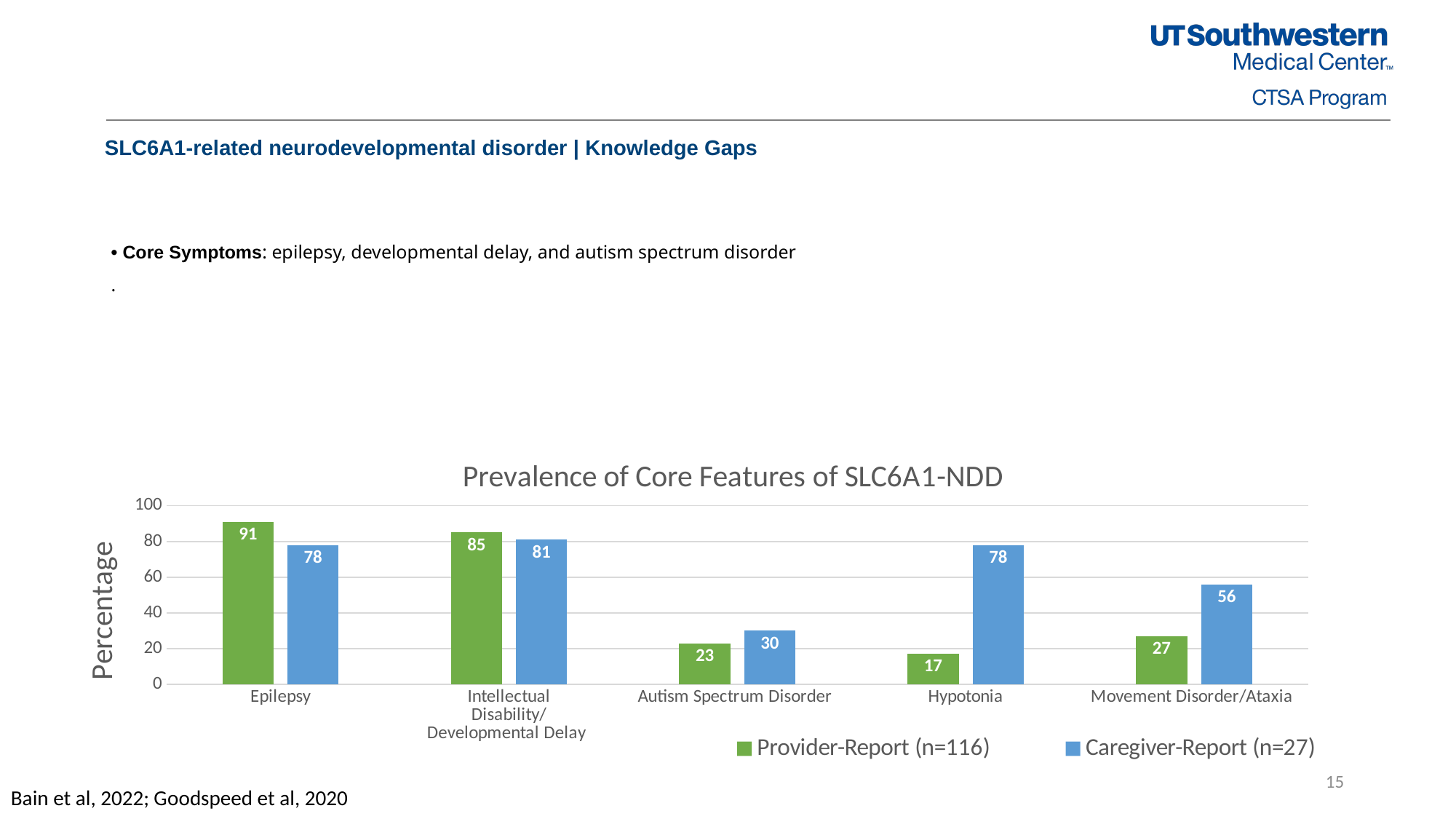
Which category has the lowest Caregiver-Report value? Autism Spectrum Disorder What kind of chart is shown on the slide? Bar chart What is the title of the chart? Prevalence of Core Features of SLC6A1-NDD How many categories are shown on the x axis? 5 What is the difference between the Provider-Report and Caregiver-Report values for Hypotonia? 61 How many series does the legend list? 2 What is the Provider-Report value for Epilepsy? 91 What is the Caregiver-Report value for Movement Disorder/Ataxia? 56 What is the Caregiver-Report value for Hypotonia? 78 For Autism Spectrum Disorder, which is larger: the Provider-Report value or the Caregiver-Report value? Caregiver-Report Which category has the highest Provider-Report value? Epilepsy Which category has the lowest Provider-Report value? Hypotonia